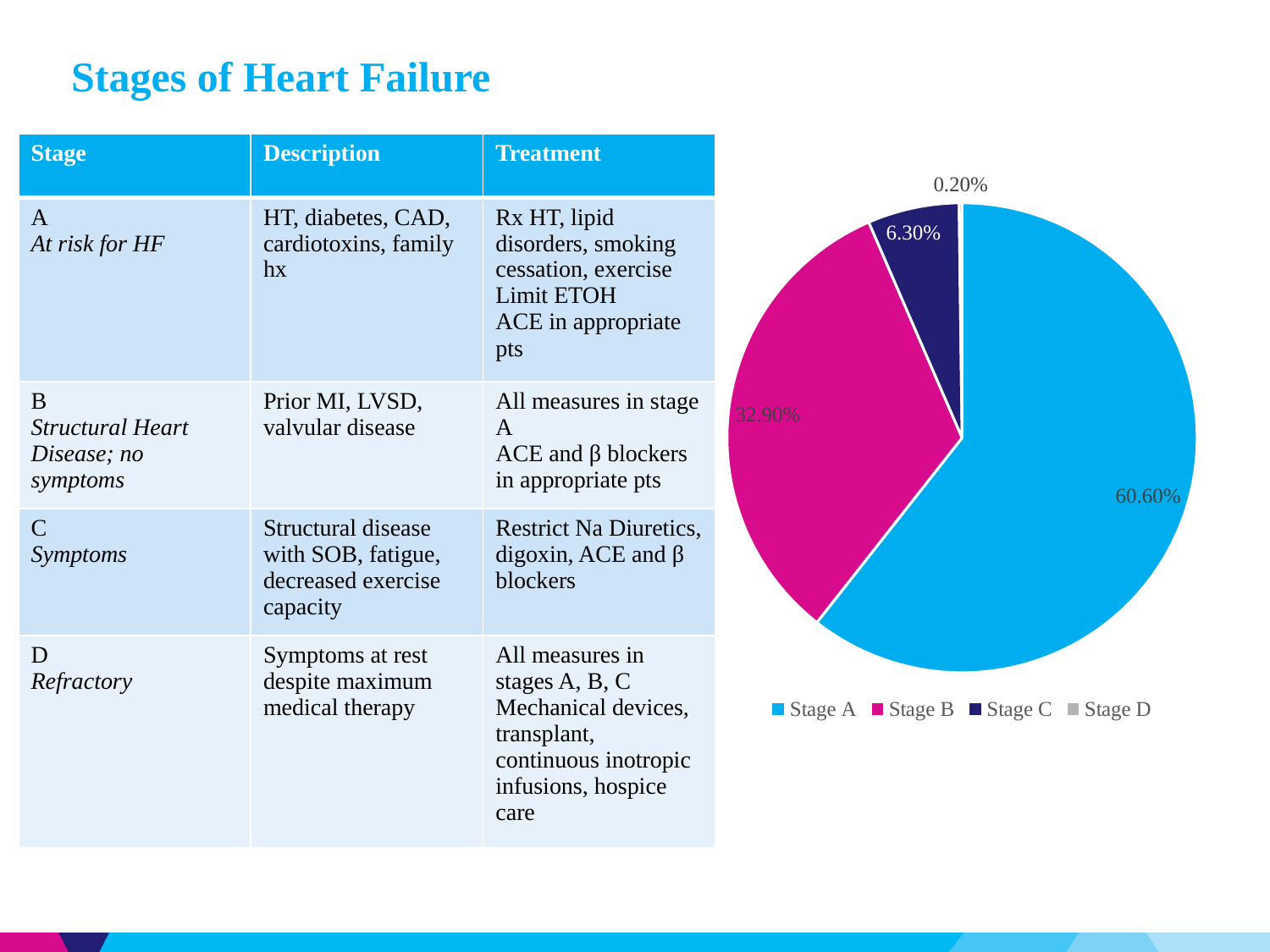
How many slices does the pie chart have? 4 Which is larger, the value for Stage B or the value for Stage C? Stage B What is the value for Stage B in the pie chart? 32.90% Which stage has the smallest slice of the pie chart? Stage D What is the value for Stage D in the pie chart? 0.20% What colour is the Stage B slice in the pie chart? magenta What is the value for Stage A in the pie chart? 60.60% What is the value for Stage C in the pie chart? 6.30% How many entries does the legend of the pie chart list? 4 What is the difference between the values for Stage A and Stage B? 27.70% What kind of chart is shown on the slide? pie chart Which stage has the largest slice of the pie chart? Stage A